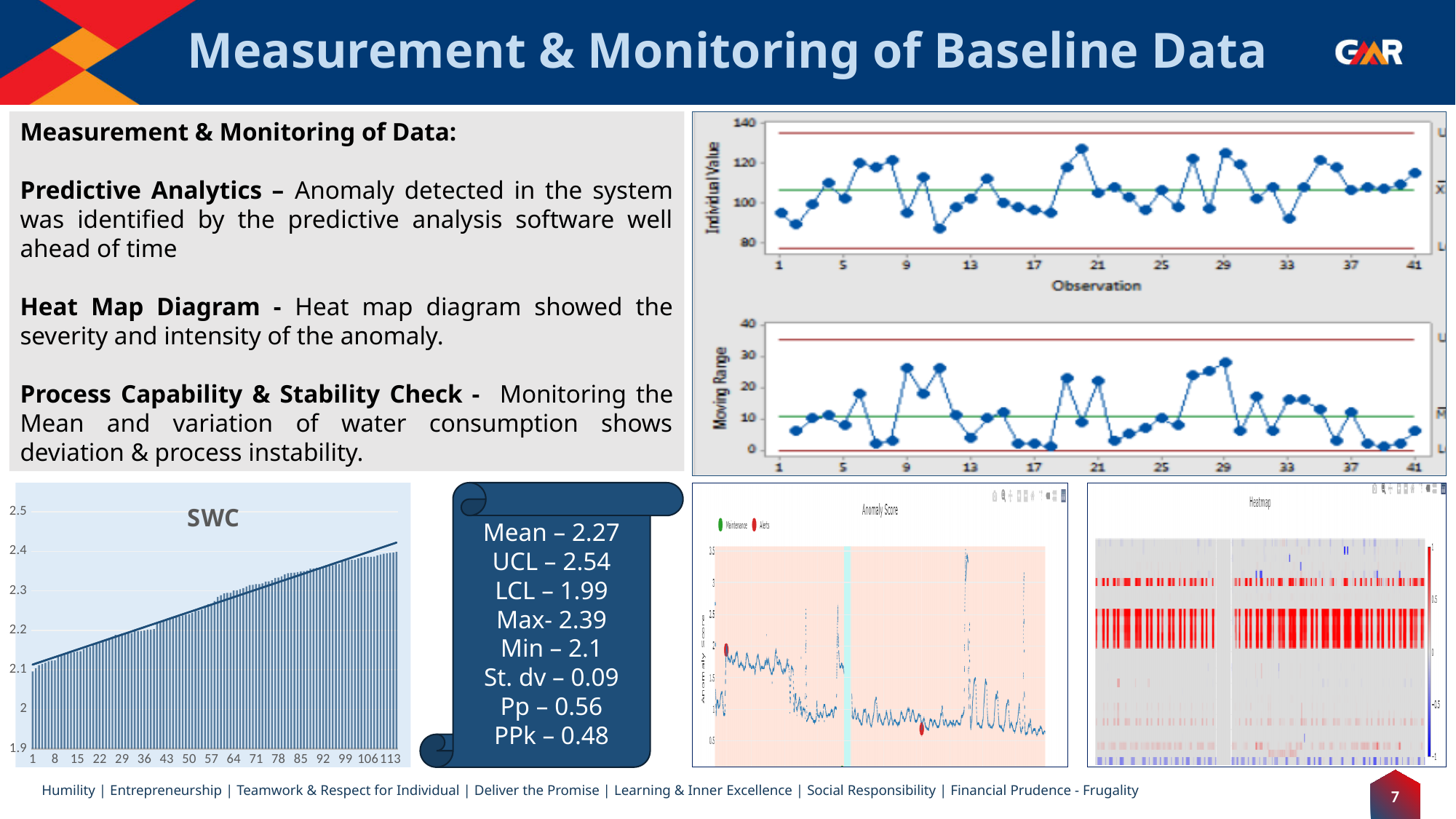
In the Individual Value chart at the top right, what is the label of the x axis? Observation In the Individual Value chart at the top right, is the value at observation 1 greater or less than 100? less In the SWC bar chart, do the values rise or fall from left to right along the x axis? rise In the Individual Value chart at the top right, is the value at observation 41 greater or less than 100? greater What is the highest value shown on the y axis of the SWC bar chart? 2.5 What kind of chart is the SWC chart at the bottom left of the slide? bar chart What is the lowest value shown on the y axis of the SWC bar chart? 1.9 How many entries does the legend of the Anomaly Score chart list? 2 In the Moving Range chart on the right, is the value at observation 29 greater or less than 20? greater